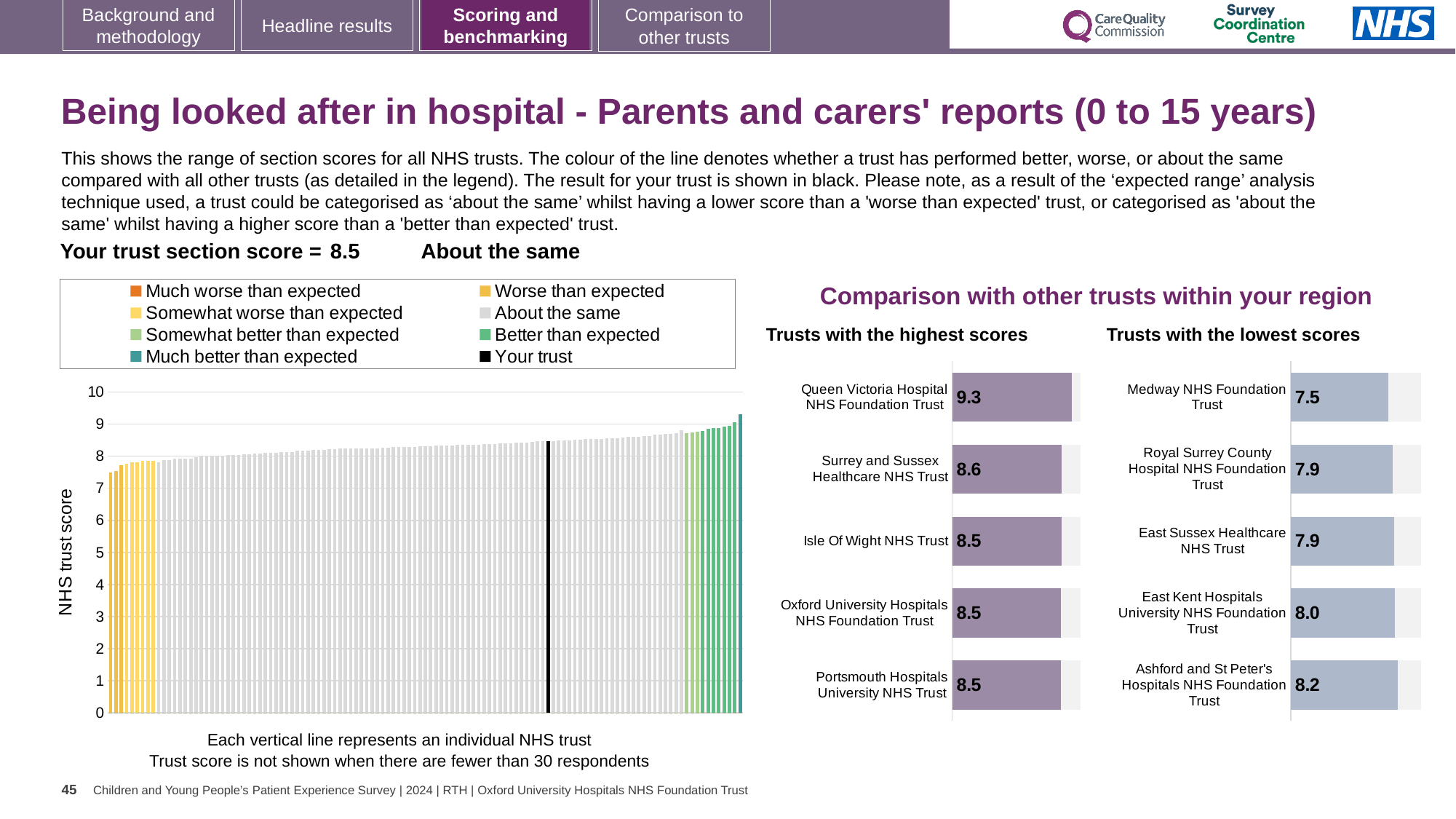
In the large chart on the left, is the value of the leftmost (lowest) bar greater or less than 8? less How many trusts are listed in the 'Trusts with the lowest scores' chart? 5 In the 'Trusts with the highest scores' chart, which trust has the highest score? Queen Victoria Hospital NHS Foundation Trust In the 'Trusts with the lowest scores' chart, which trust has the lowest score? Medway NHS Foundation Trust In the 'Trusts with the lowest scores' chart, which has the larger score: East Kent Hospitals University NHS Foundation Trust or Ashford and St Peter's Hospitals NHS Foundation Trust? Ashford and St Peter's Hospitals NHS Foundation Trust In the 'Trusts with the highest scores' chart, what is the score for Queen Victoria Hospital NHS Foundation Trust? 9.3 In the 'Trusts with the highest scores' chart, what is the difference between the scores of Queen Victoria Hospital NHS Foundation Trust and Surrey and Sussex Healthcare NHS Trust? 0.7 In the 'Trusts with the lowest scores' chart, what is the score for Medway NHS Foundation Trust? 7.5 What kind of chart is the large chart on the left showing NHS trust scores? Bar chart How many entries does the legend above the large chart on the left list? 8 In the large chart on the left, do the trust scores rise or fall from left to right? Rise In the 'Trusts with the lowest scores' chart, what is the score for East Kent Hospitals University NHS Foundation Trust? 8.0